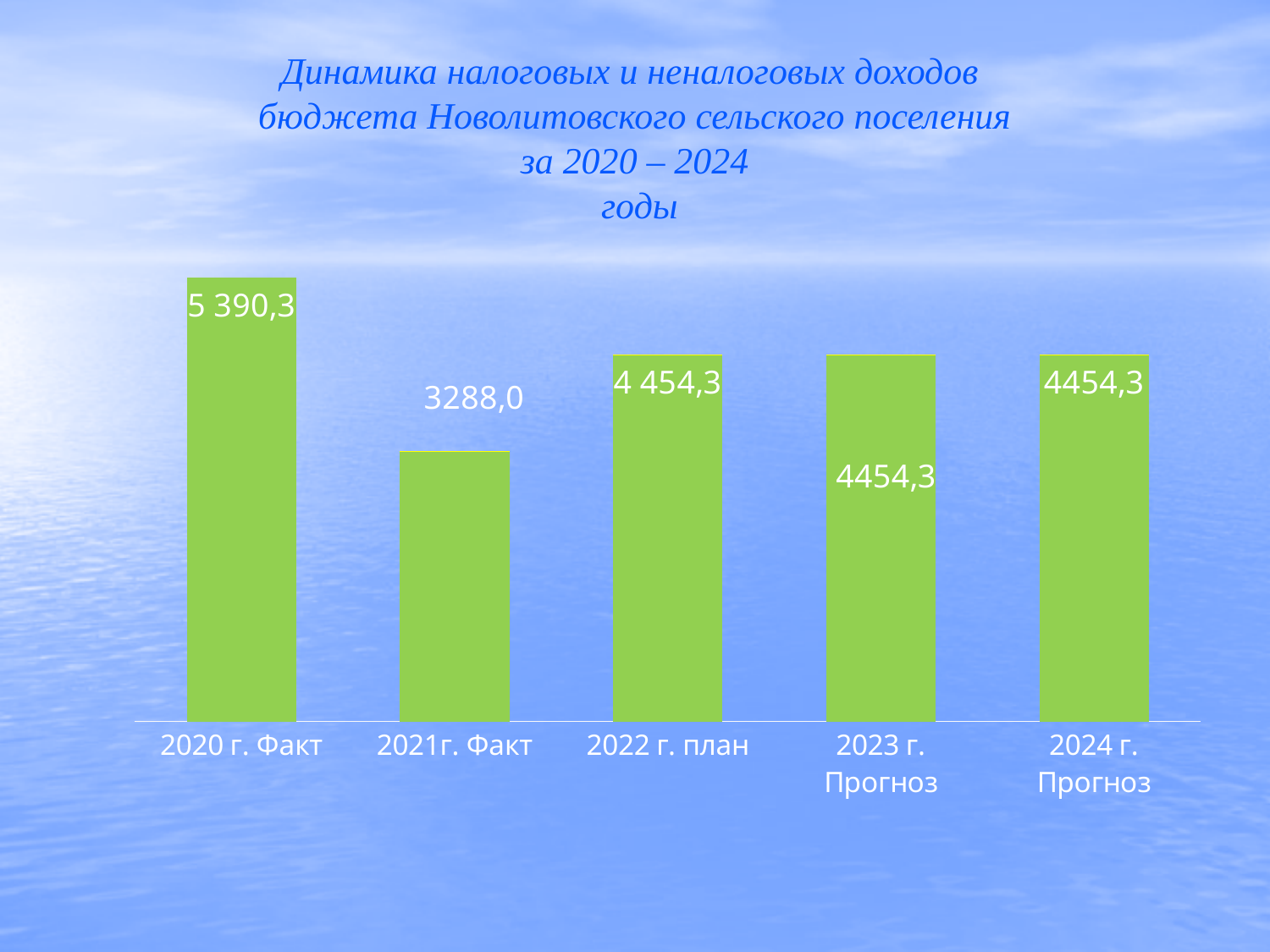
What is the value for 2022 г. план? 4 454,3 What is the value for 2021г. Факт? 3288,0 Which category has the highest value? 2020 г. Факт What is the difference between the values for 2020 г. Факт and 2021г. Факт? 2102,3 What colour are the bars in the chart? green Which is larger, the value for 2021г. Факт or the value for 2023 г. Прогноз? 2023 г. Прогноз What is the value for 2024 г. Прогноз? 4454,3 What kind of chart is shown on the slide? bar chart Which category has the lowest value? 2021г. Факт What is the difference between the values for 2020 г. Факт and 2022 г. план? 936,0 What is the value for 2020 г. Факт? 5 390,3 How many categories are shown on the chart? 5